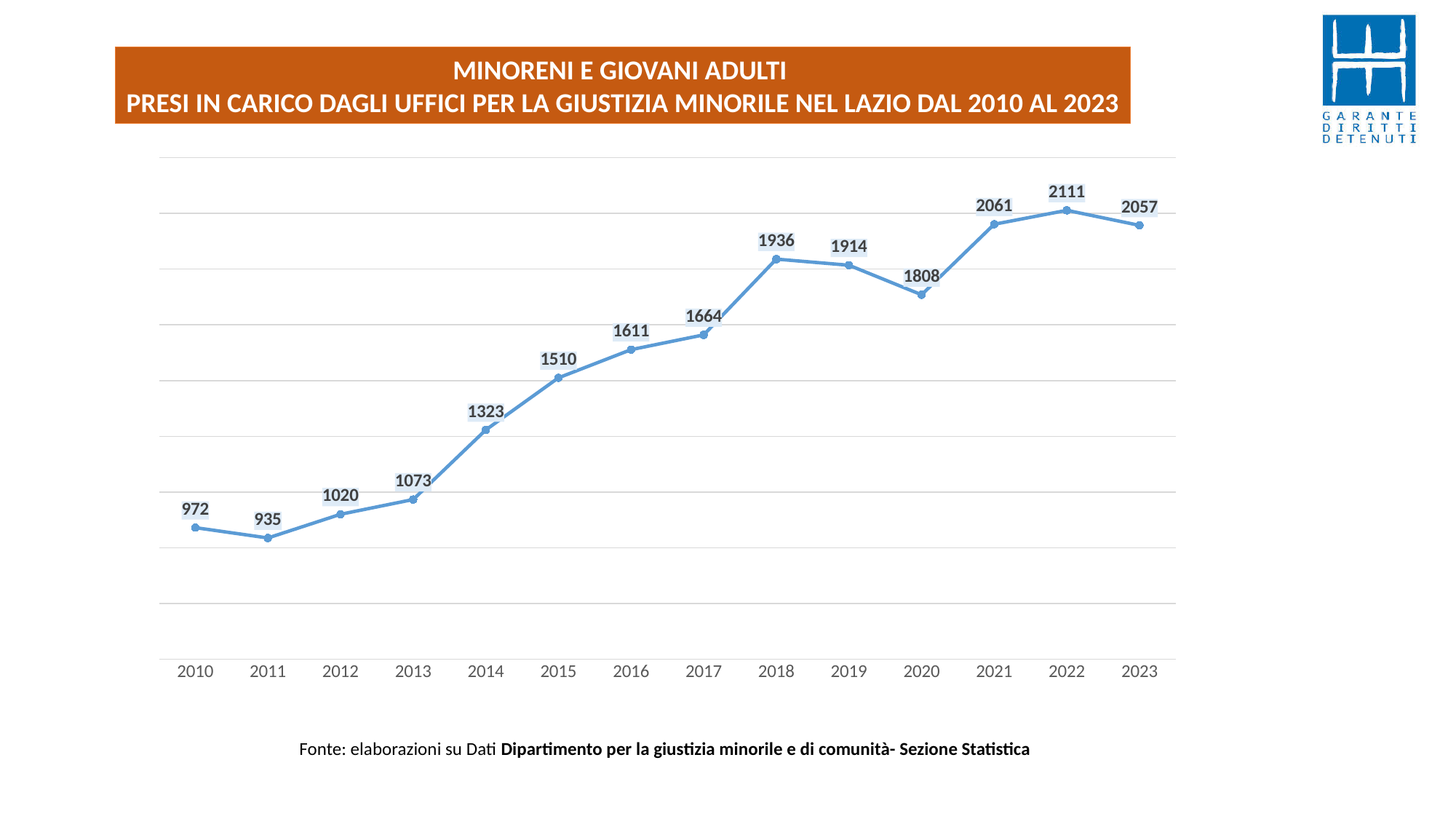
What is the difference between the values for 2022 and 2010? 1139 Which is larger, the value for 2021 or the value for 2023? 2021 What is the value for 2010? 972 What is the value for 2023? 2057 Which year has the lowest value? 2011 What is the difference between the values for 2019 and 2020? 106 What is the source cited below the chart? Dipartimento per la giustizia minorile e di comunità- Sezione Statistica What kind of chart is shown on the slide? line chart What is the value for 2018? 1936 Which year has the highest value? 2022 How many years are plotted on the chart? 14 Do the values generally rise or fall from 2010 to 2023? rise